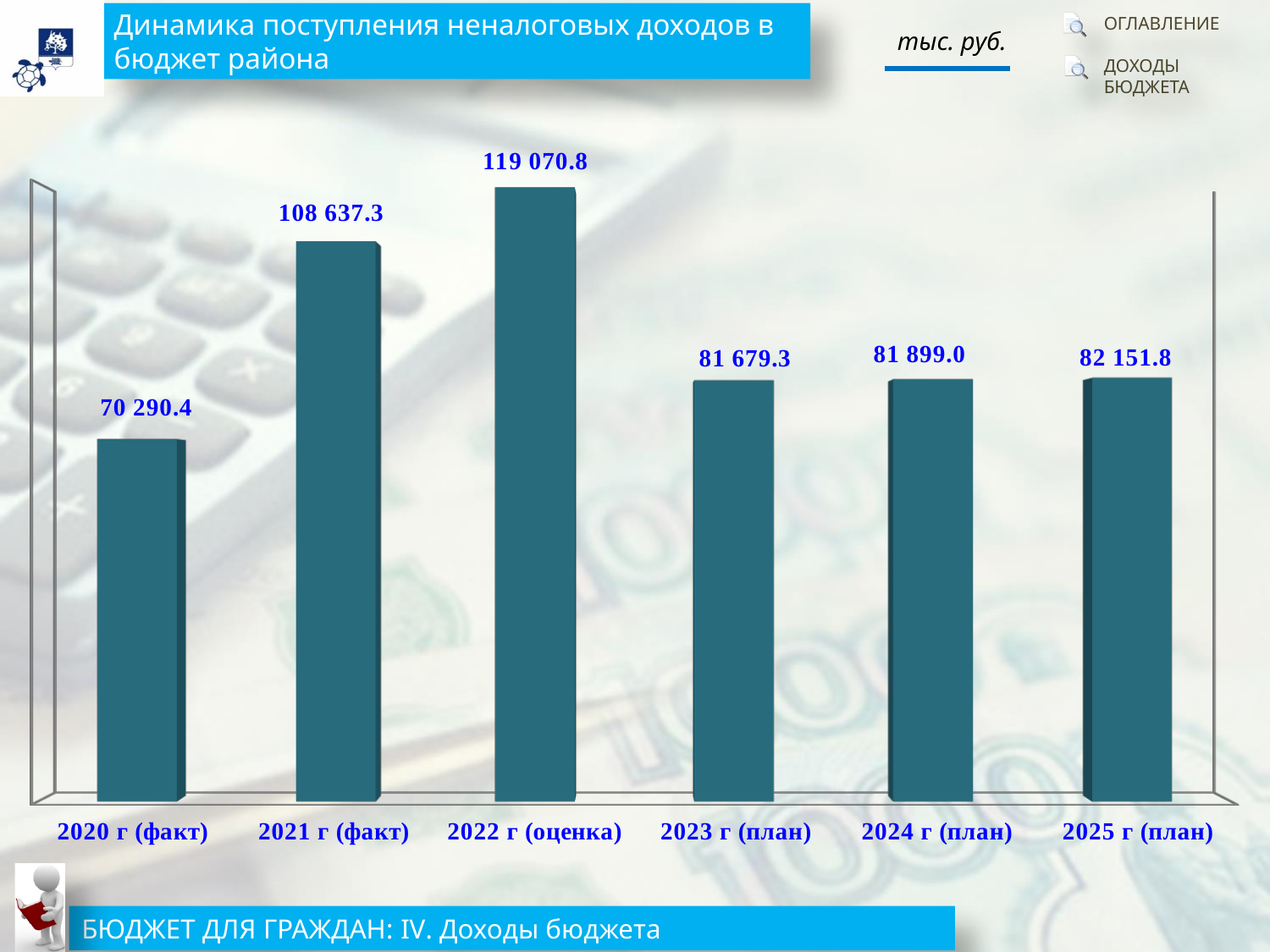
Which is larger, the value for 2021 г (факт) or the value for 2023 г (план)? 2021 г (факт) Which category has the lowest value? 2020 г (факт) What is the value for 2022 г (оценка)? 119 070.8 What is the difference between the values for 2022 г (оценка) and 2021 г (факт)? 10 433.5 What is the value for 2025 г (план)? 82 151.8 How many categories are shown on the chart? 6 What unit of measurement is indicated for the chart values? тыс. руб. What is the value for 2023 г (план)? 81 679.3 What is the value for 2020 г (факт)? 70 290.4 What is the difference between the values for 2021 г (факт) and 2020 г (факт)? 38 346.9 What kind of chart is shown on the slide? Bar chart Which category has the highest value? 2022 г (оценка)